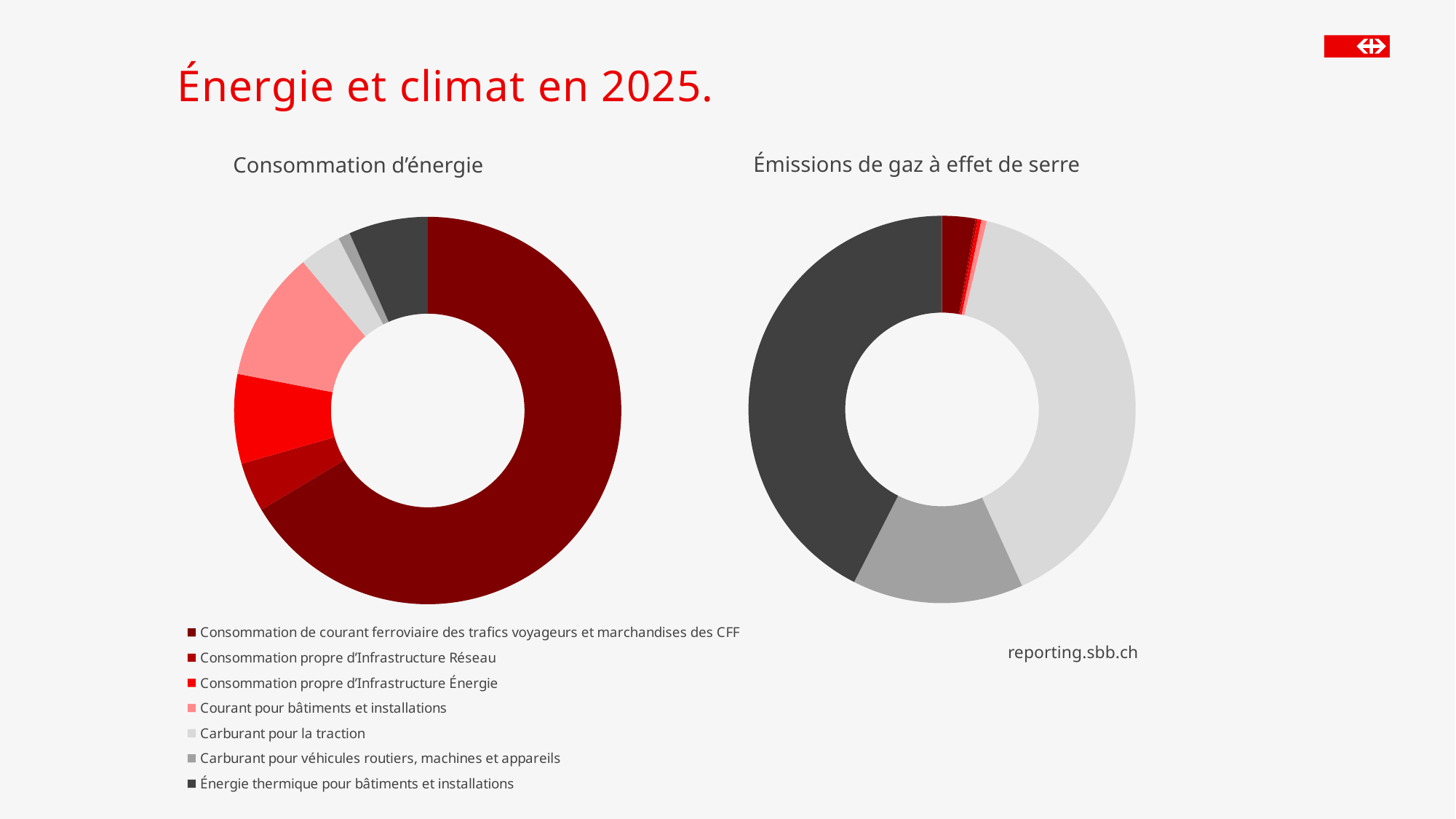
In the 'Consommation d’énergie' chart, which is larger: 'Courant pour bâtiments et installations' or 'Carburant pour la traction'? Courant pour bâtiments et installations In the 'Consommation d’énergie' chart, which category has the largest share? Consommation de courant ferroviaire des trafics voyageurs et marchandises des CFF How many slices does the 'Consommation d’énergie' chart have? 7 How many entries does the legend list? 7 In the 'Émissions de gaz à effet de serre' chart, which is larger: 'Énergie thermique pour bâtiments et installations' or 'Consommation de courant ferroviaire des trafics voyageurs et marchandises des CFF'? Énergie thermique pour bâtiments et installations What is the title of the chart on the left of the slide? Consommation d’énergie What kind of chart is the 'Consommation d’énergie' chart? Doughnut chart In the 'Consommation d’énergie' chart, which category has the smallest share? Carburant pour véhicules routiers, machines et appareils In the 'Émissions de gaz à effet de serre' chart, which is larger: 'Carburant pour la traction' or 'Carburant pour véhicules routiers, machines et appareils'? Carburant pour la traction What kind of chart is the 'Émissions de gaz à effet de serre' chart? Doughnut chart What is the title of the chart on the right of the slide? Émissions de gaz à effet de serre